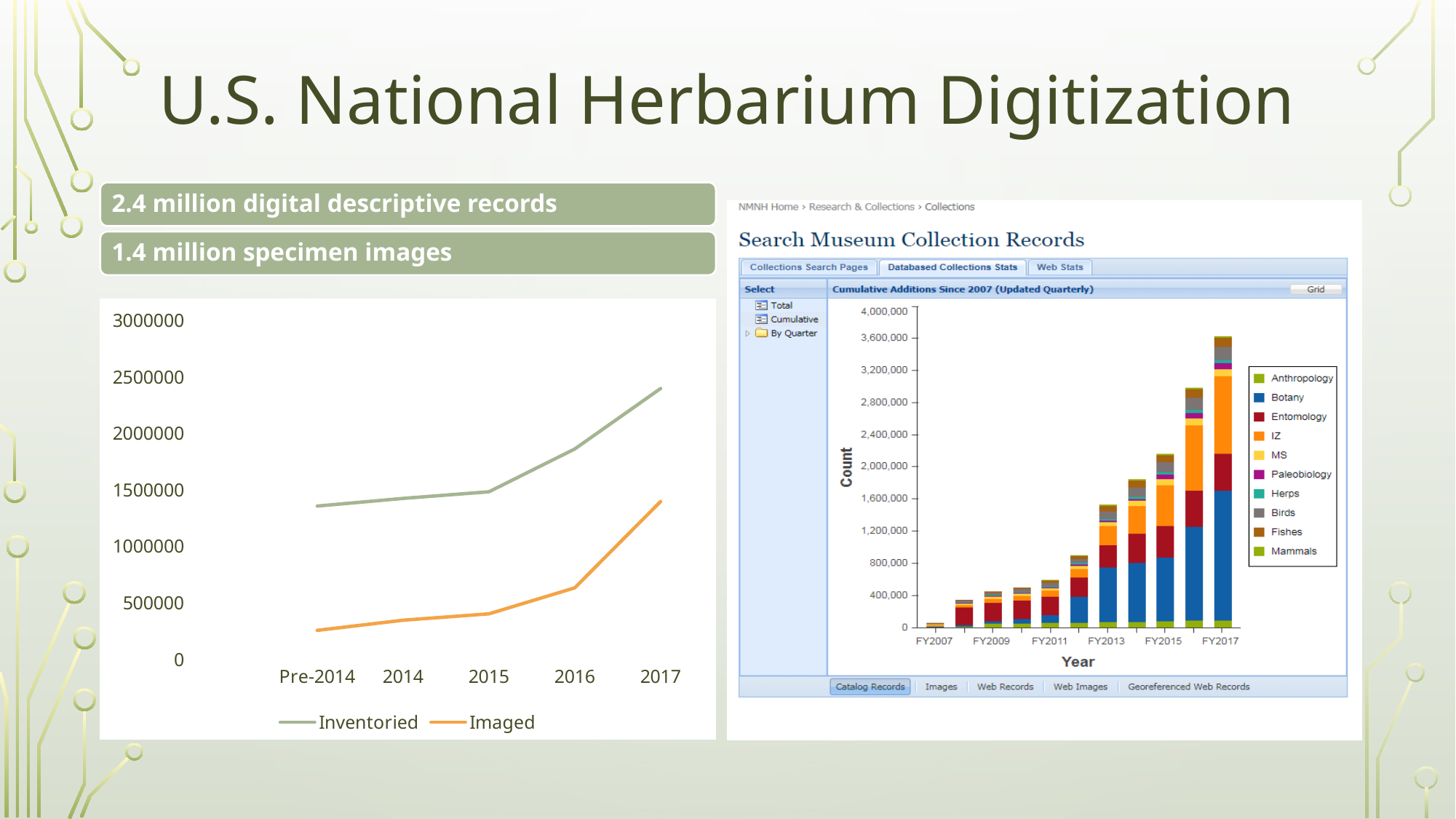
In the 'Cumulative Additions Since 2007' chart on the right, how many series does the legend list? 10 In the left-hand line chart, is the Inventoried value for 2016 greater or less than 2000000? less In the left-hand line chart, is the Inventoried value for 2017 greater or less than 2000000? greater In the left-hand line chart, which series is higher in 2017, Inventoried or Imaged? Inventoried In the left-hand line chart, is the Imaged value for Pre-2014 greater or less than 500000? less What kind of chart is the 'Cumulative Additions Since 2007 (Updated Quarterly)' chart on the right? bar chart In the left-hand line chart, how many categories are shown on the x axis? 5 What kind of chart is the left-hand chart with the Inventoried and Imaged series? line chart In the left-hand line chart, how many series does the legend list? 2 In the left-hand line chart, does the Imaged series rise or fall from Pre-2014 to 2017? rise